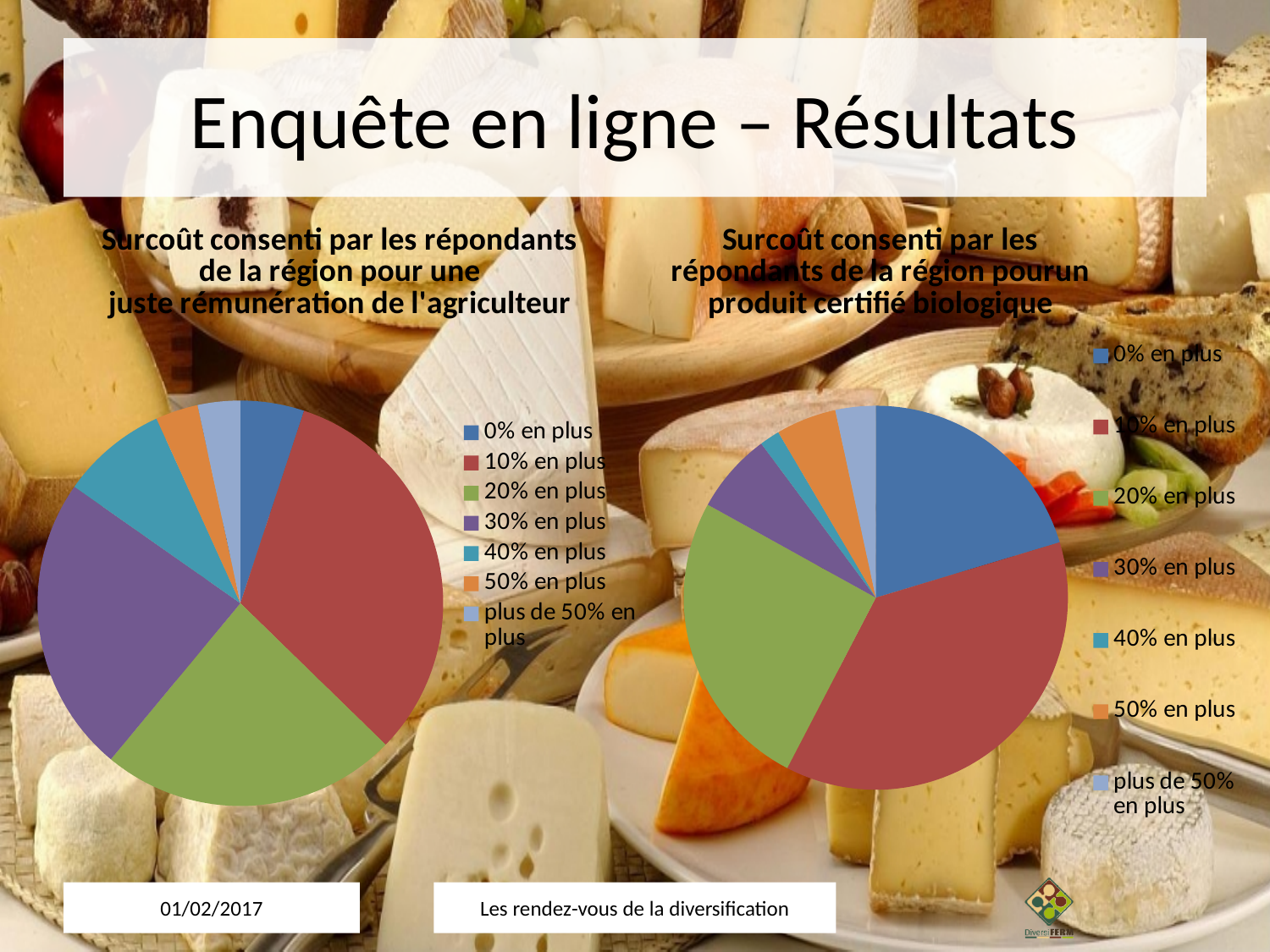
In the right chart (produit certifié biologique), how many slices does the pie have? 7 In the right chart (produit certifié biologique), which slice is larger: '20% en plus' or '50% en plus'? 20% en plus What kind of chart is used for 'Surcoût consenti par les répondants de la région pour une juste rémunération de l'agriculteur'? pie chart In the left chart (juste rémunération de l'agriculteur), how many categories does the legend list? 7 In the right chart (produit certifié biologique), which category has the largest slice? 10% en plus What kind of chart is used for 'Surcoût consenti par les répondants de la région pour un produit certifié biologique'? pie chart In the left chart (juste rémunération de l'agriculteur), which slice is larger: '20% en plus' or '0% en plus'? 20% en plus What is the last legend entry listed for the left chart (juste rémunération de l'agriculteur)? plus de 50% en plus In the left chart (juste rémunération de l'agriculteur), which category has the largest slice? 10% en plus In the left chart (juste rémunération de l'agriculteur), which slice is larger: '30% en plus' or '40% en plus'? 30% en plus In the right chart (produit certifié biologique), which category has the smallest slice? 40% en plus